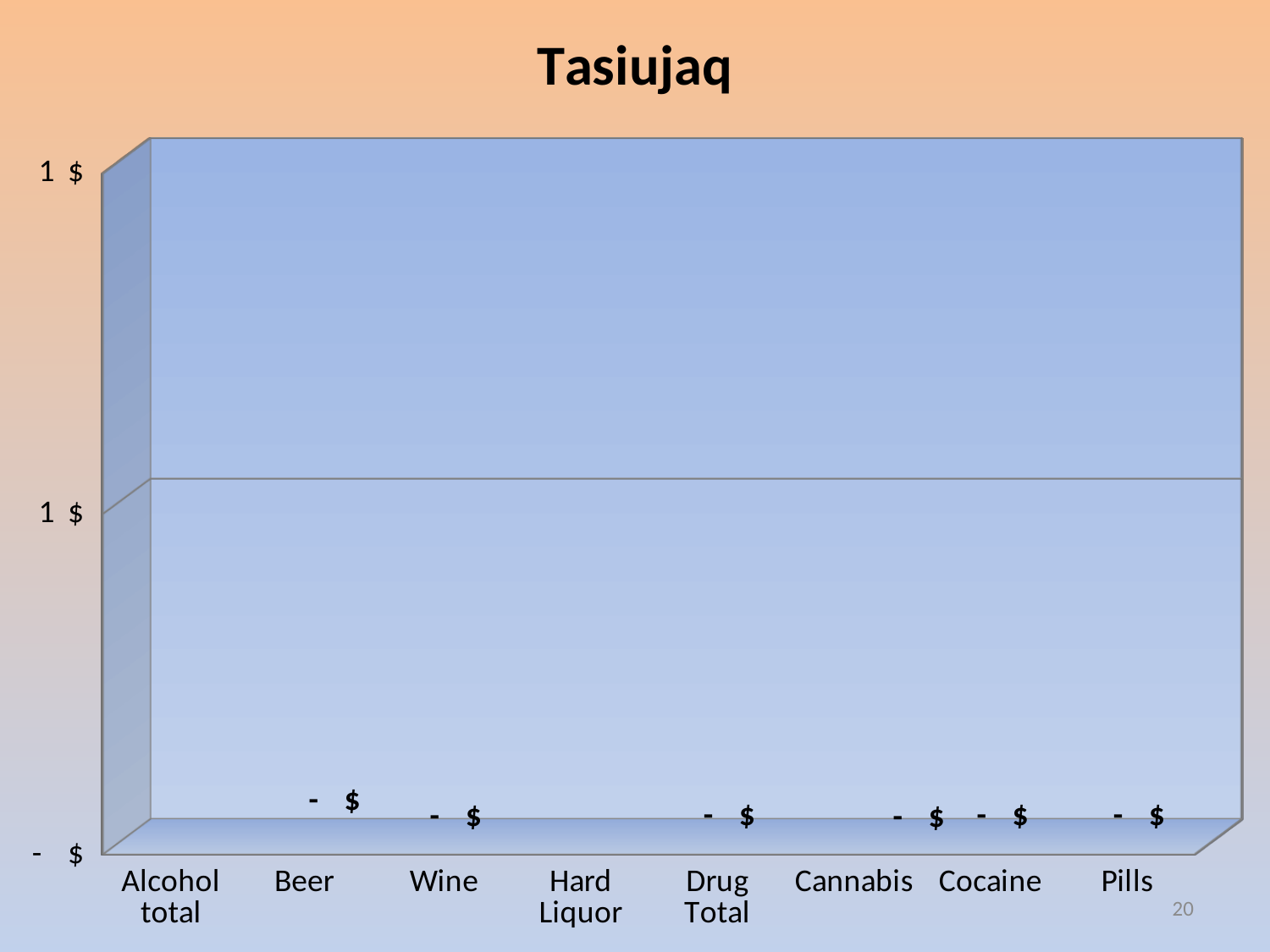
What is the title of the chart? Tasiujaq What is the data label shown for Wine? - $ What kind of chart is shown on the slide? bar chart How many categories are shown on the x axis of the chart? 8 What is the data label shown for Beer? - $ What is the first category listed on the x axis? Alcohol total What is the data label shown for Pills? - $ What is the data label shown for Cocaine? - $ What is the data label shown for Cannabis? - $ What is the data label shown for Drug Total? - $